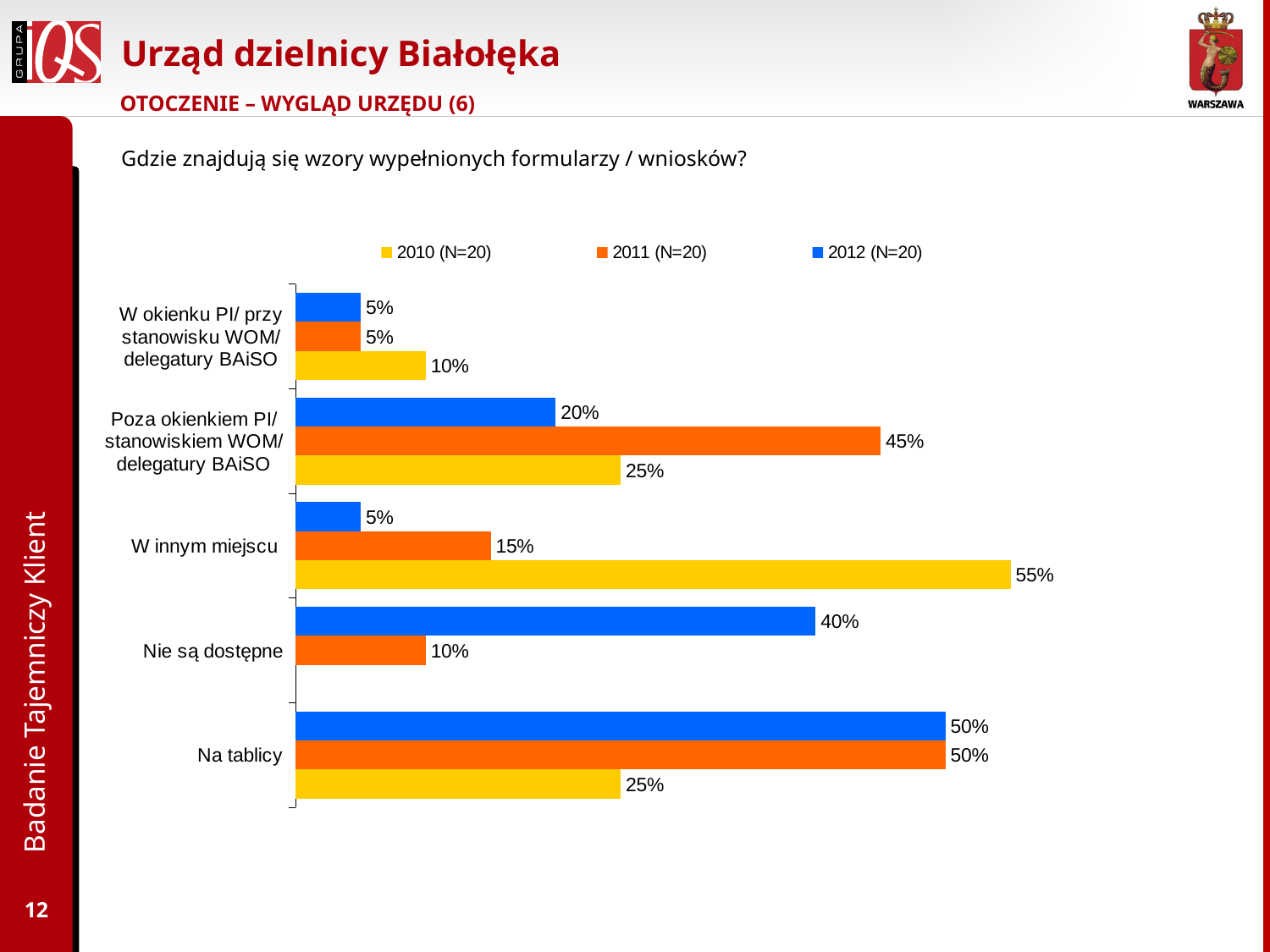
What is the difference between the 2010 and 2012 values for 'W innym miejscu'? 50% Which colour represents the 2011 (N=20) series? Orange Which category has the lowest value in the 2011 (N=20) series? W okienku PI/ przy stanowisku WOM/ delegatury BAiSO Which is larger for 'Nie są dostępne': the 2011 value or the 2012 value? 2012 What is the value for 'Na tablicy' in the 2012 (N=20) series? 50% What kind of chart is shown on the slide? Bar chart What is the value for 'Poza okienkiem PI/ stanowiskiem WOM/ delegatury BAiSO' in the 2011 (N=20) series? 45% Which category has the highest value in the 2010 (N=20) series? W innym miejscu What is the value for 'Nie są dostępne' in the 2012 (N=20) series? 40% How many categories are shown on the chart? 5 What is the value for 'W innym miejscu' in the 2010 (N=20) series? 55% How many series does the legend list? 3